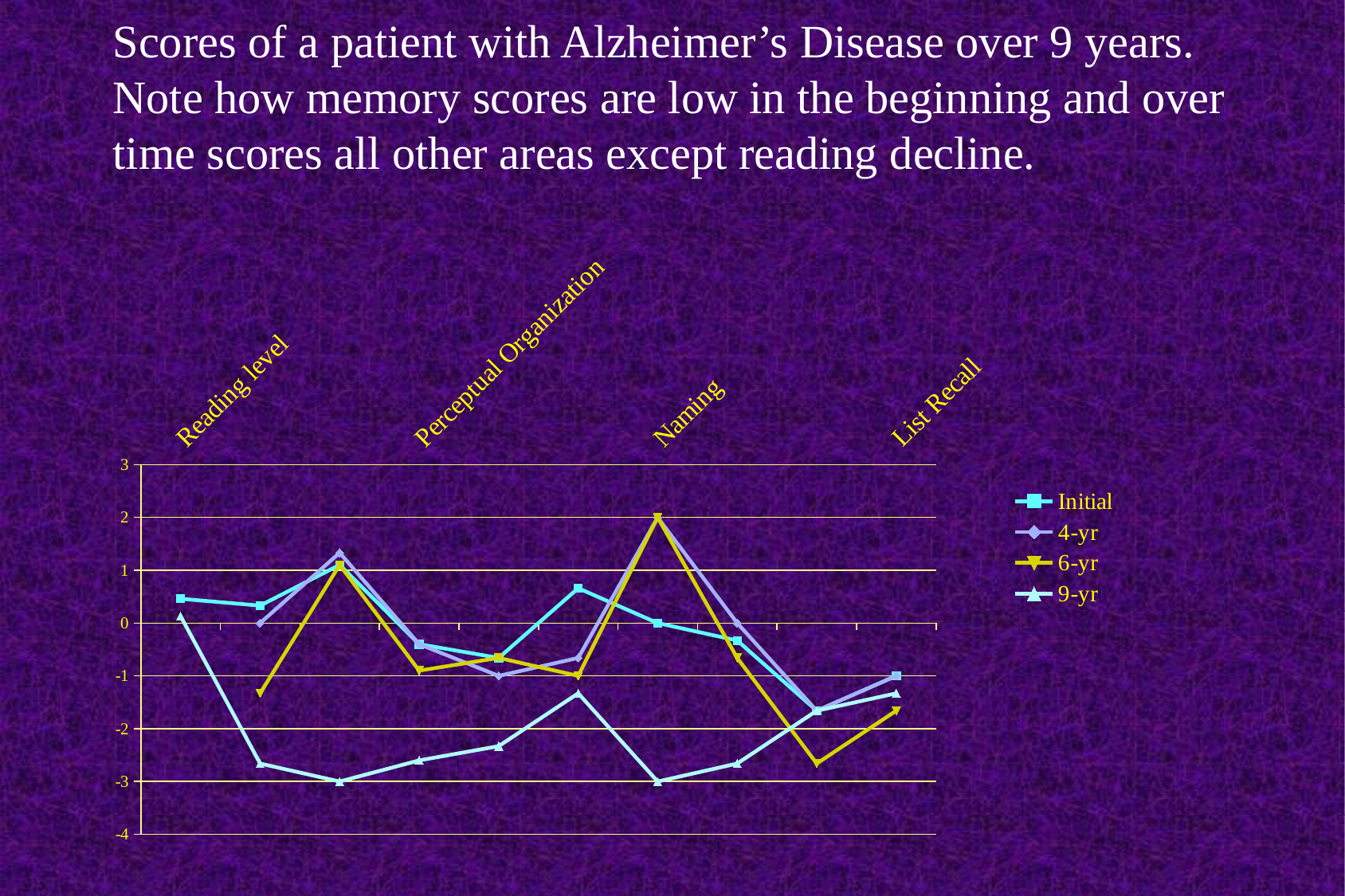
Is the Initial value for Reading level greater or less than 0? greater Which series has the lowest value at Naming? 9-yr Is the 9-yr value for Perceptual Organization greater or less than -2? less At List Recall, which is larger: the 9-yr value or the 6-yr value? 9-yr What is the 9-yr value for Naming? -3 What are the series names listed in the legend? Initial, 4-yr, 6-yr, 9-yr How many category labels are shown along the x axis? 4 What kind of chart is shown on the slide? line chart What is the 6-yr value for Naming? 2 How many series does the legend list? 4 What is the Initial value for Naming? 0